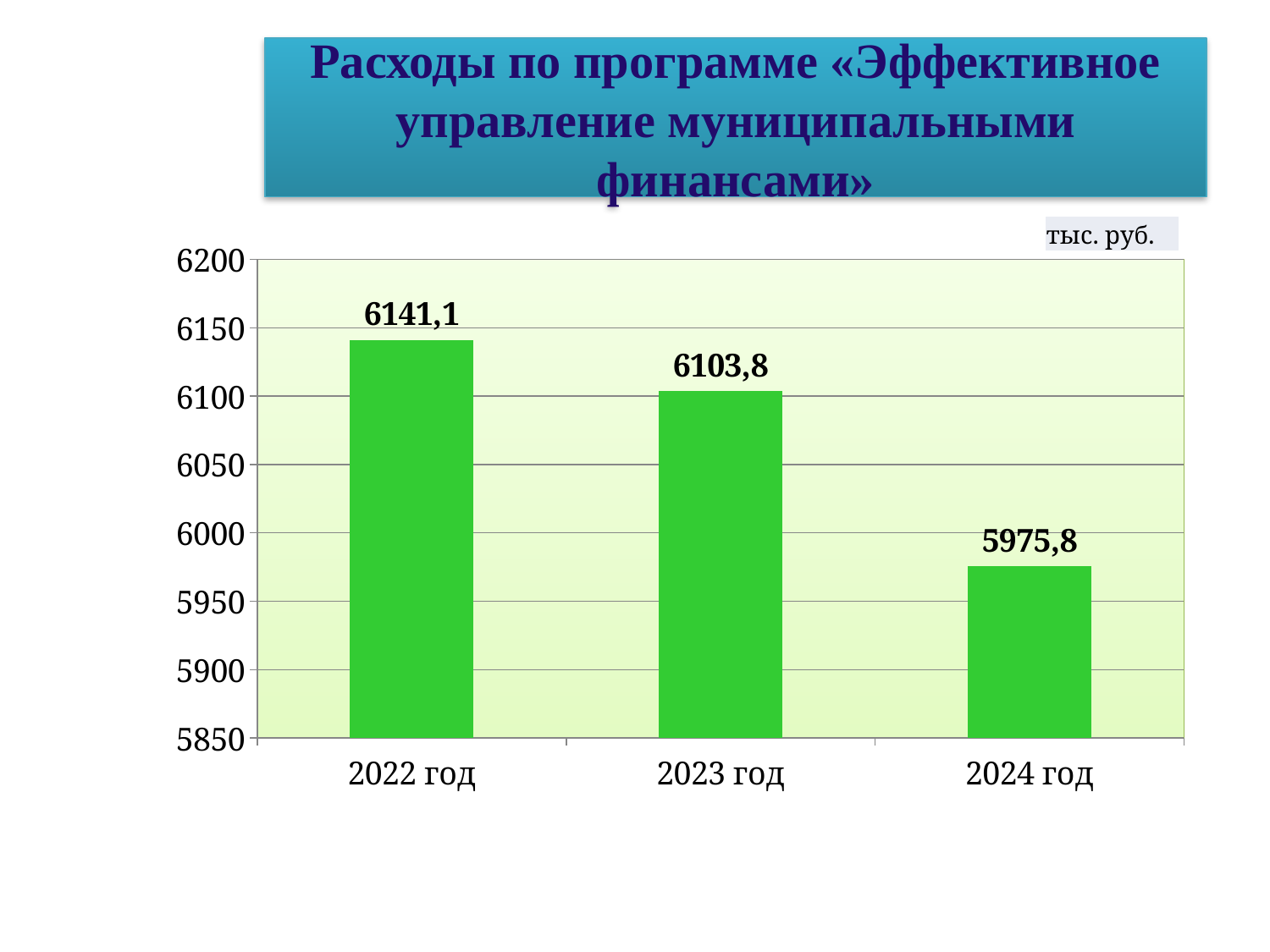
Which is larger, the value for 2023 год or the value for 2024 год? 2023 год Which year has the lowest value? 2024 год What is the difference between the values for 2023 год and 2024 год? 128 Is the value for 2024 год greater or less than 6000? less Do the values rise or fall from 2022 год to 2024 год? fall What kind of chart is shown on the slide? bar chart How many years are shown on the chart? 3 Which year has the highest value? 2022 год What is the value for 2024 год? 5975,8 What is the difference between the values for 2022 год and 2023 год? 37,3 What is the value for 2022 год? 6141,1 What is the value for 2023 год? 6103,8